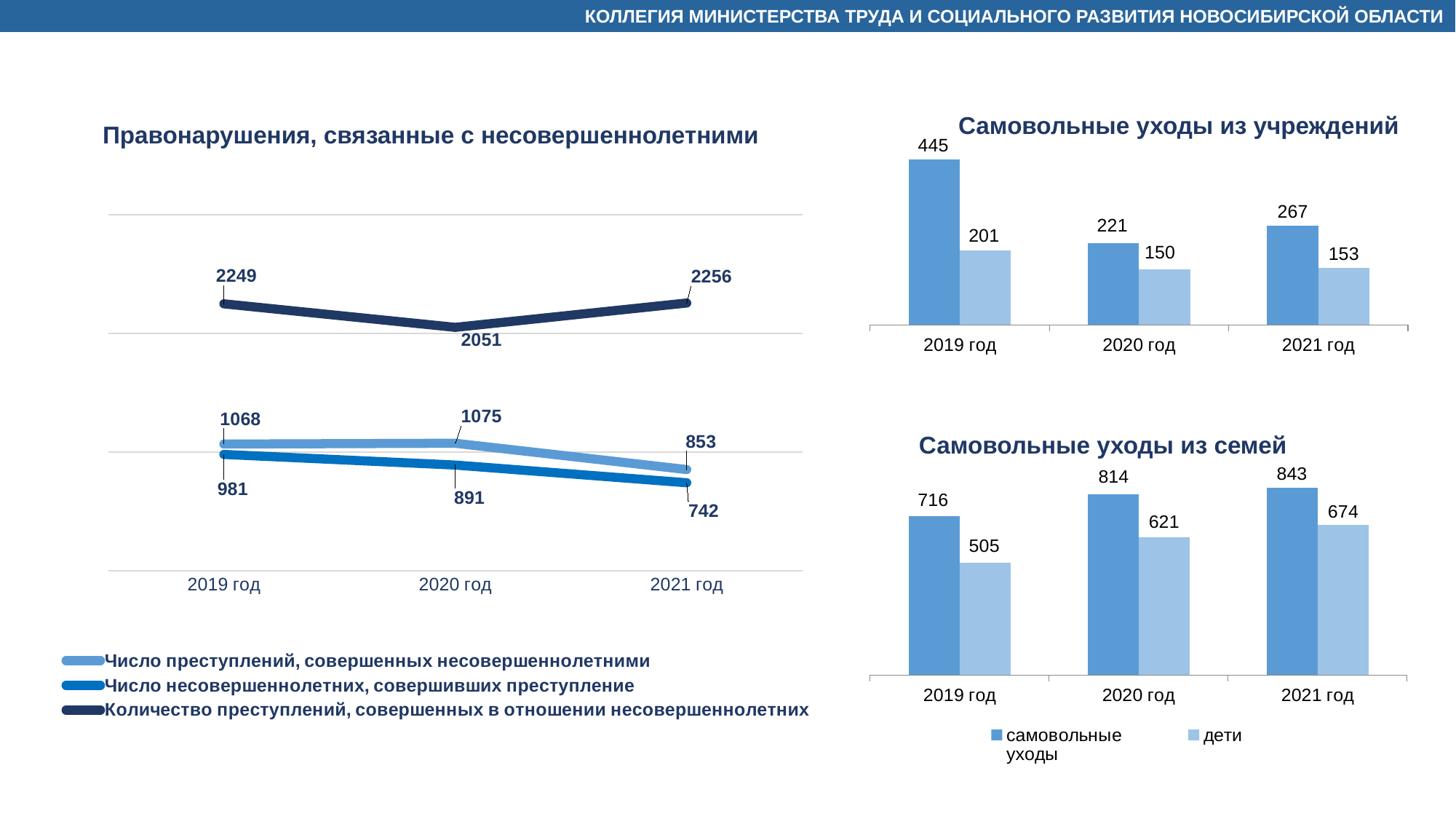
In the chart 'Самовольные уходы из семей', does the value of 'самовольные уходы' rise or fall from 2019 год to 2021 год? rise What type of chart is 'Правонарушения, связанные с несовершеннолетними'? line chart In the chart 'Самовольные уходы из учреждений', in which year is the value of 'дети' lowest? 2020 год In the chart 'Правонарушения, связанные с несовершеннолетними', what is the value of 'Число несовершеннолетних, совершивших преступление' for 2021 год? 742 In the chart 'Самовольные уходы из учреждений', what is the difference between 'самовольные уходы' and 'дети' in 2021 год? 114 In the chart 'Самовольные уходы из семей', what is the value of 'дети' for 2020 год? 621 In the chart 'Правонарушения, связанные с несовершеннолетними', what is the value of 'Количество преступлений, совершенных в отношении несовершеннолетних' for 2020 год? 2051 In the chart 'Самовольные уходы из учреждений', what is the value of 'самовольные уходы' for 2019 год? 445 In the chart 'Правонарушения, связанные с несовершеннолетними', how many series does the legend list? 3 In the chart 'Правонарушения, связанные с несовершеннолетними', in which year is 'Число преступлений, совершенных несовершеннолетними' highest? 2020 год In the chart 'Правонарушения, связанные с несовершеннолетними', what is the difference between 'Число преступлений, совершенных несовершеннолетними' in 2019 год and 2021 год? 215 What type of chart is 'Самовольные уходы из семей'? bar chart